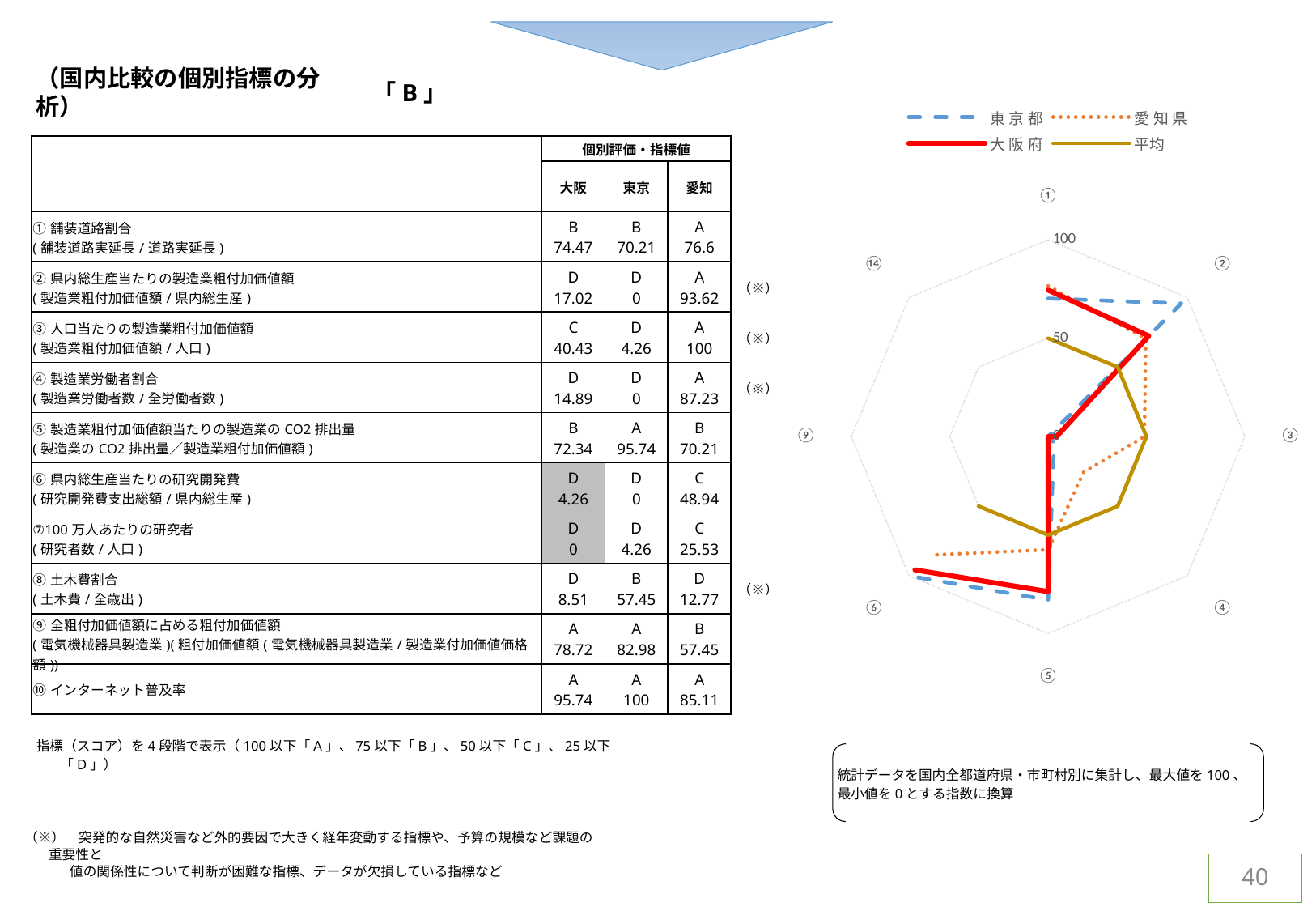
In the radar chart, which is larger on axis ②: 愛知県 or 東京都? 東京都 How many series does the legend of the radar chart list? 4 In the radar chart, is the value for 東京都 on axis ② greater or less than 50? greater In the radar chart, is the value for 東京都 on axis ⑤ greater or less than 50? greater Which series in the radar chart is drawn with a solid red line? 大阪府 Which series in the radar chart is drawn with a dotted orange line? 愛知県 What kind of chart is shown on the right side of the slide? radar chart How many axes (spokes) does the radar chart have? 8